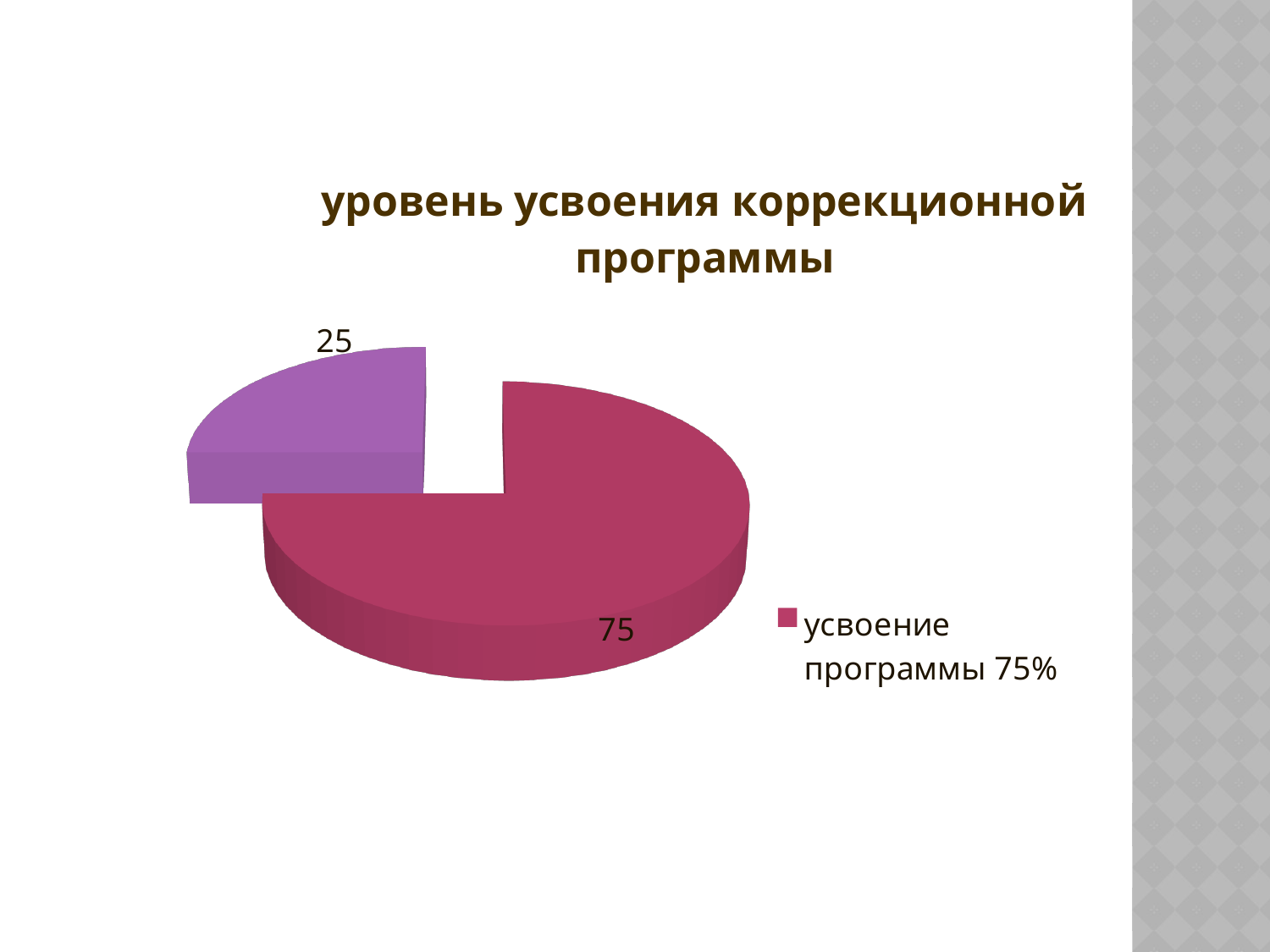
How many slices does the pie chart have? 2 Which slice is larger: the red slice or the purple slice? the red slice What share of the pie does the slice labelled 75 represent? 75% What value is shown on the purple slice of the pie chart? 25 What is the difference between the two slice values in the pie chart? 50 What is the title of the chart? уровень усвоения коррекционной программы What value is shown for the slice labelled "усвоение программы 75%" in the legend? 75 How many entries does the legend list? 1 What is the value of the smallest slice in the pie chart? 25 What kind of chart is shown on the slide? pie chart What colour is the slice for "усвоение программы 75%"? red Which slice is the largest in the pie chart? усвоение программы 75%